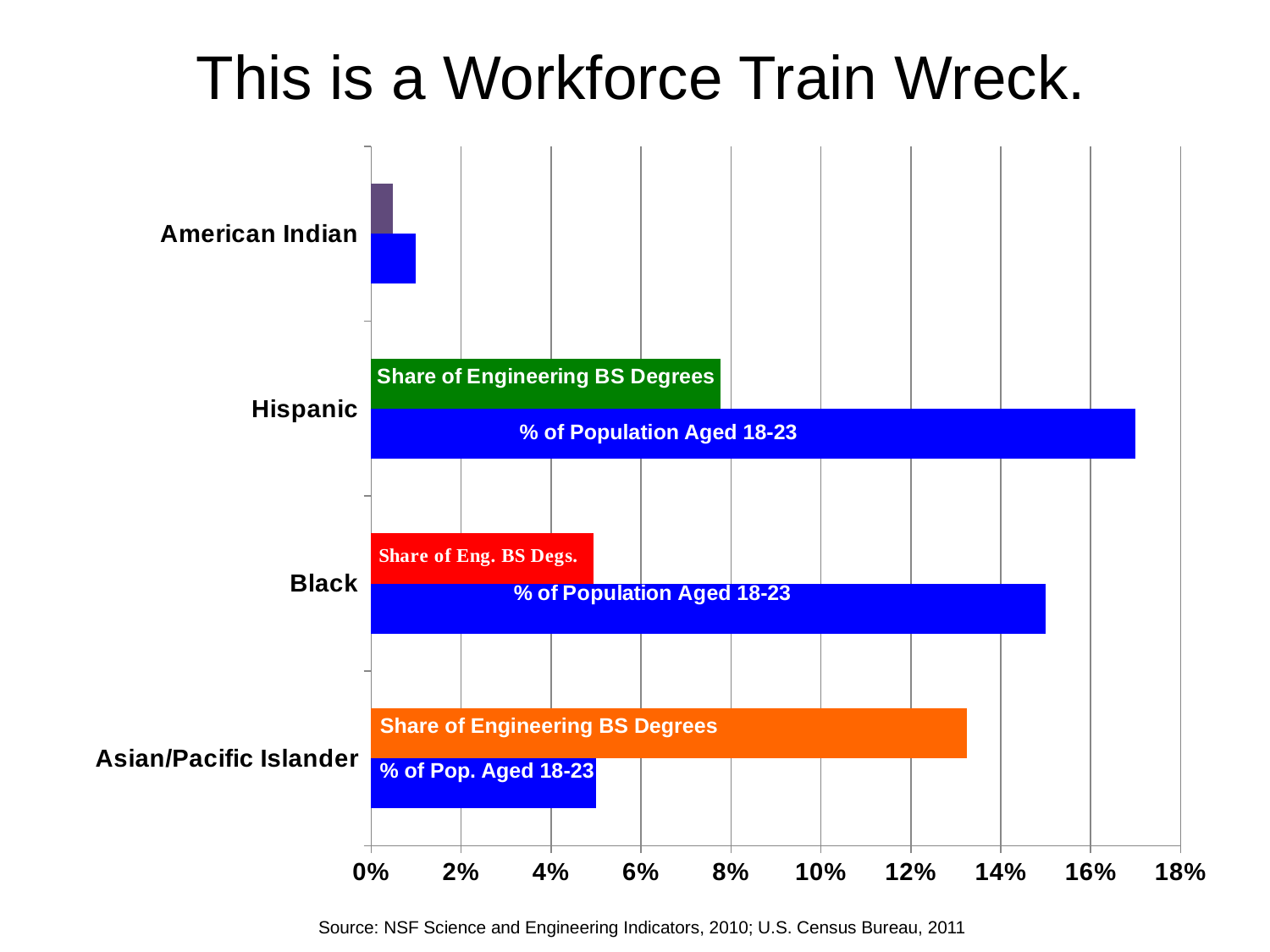
For Hispanic, which is larger: the Share of Engineering BS Degrees or the % of Population Aged 18-23? % of Population Aged 18-23 What is the title of the slide containing the chart? This is a Workforce Train Wreck. What kind of chart is shown on the slide? Bar chart Is the % of Population Aged 18-23 value for Hispanic greater or less than 16%? greater Is the Share of Engineering BS Degrees value for Asian/Pacific Islander greater or less than 12%? greater How many categories (racial/ethnic groups) are shown on the chart? 4 Which group has the lowest % of Population Aged 18-23 bar? American Indian For Asian/Pacific Islander, which is larger: the Share of Engineering BS Degrees or the % of Pop. Aged 18-23? Share of Engineering BS Degrees Which group has the highest % of Population Aged 18-23 bar? Hispanic Is the % of Population Aged 18-23 value for Black greater or less than 14%? greater Which group has the highest Share of Engineering BS Degrees bar? Asian/Pacific Islander